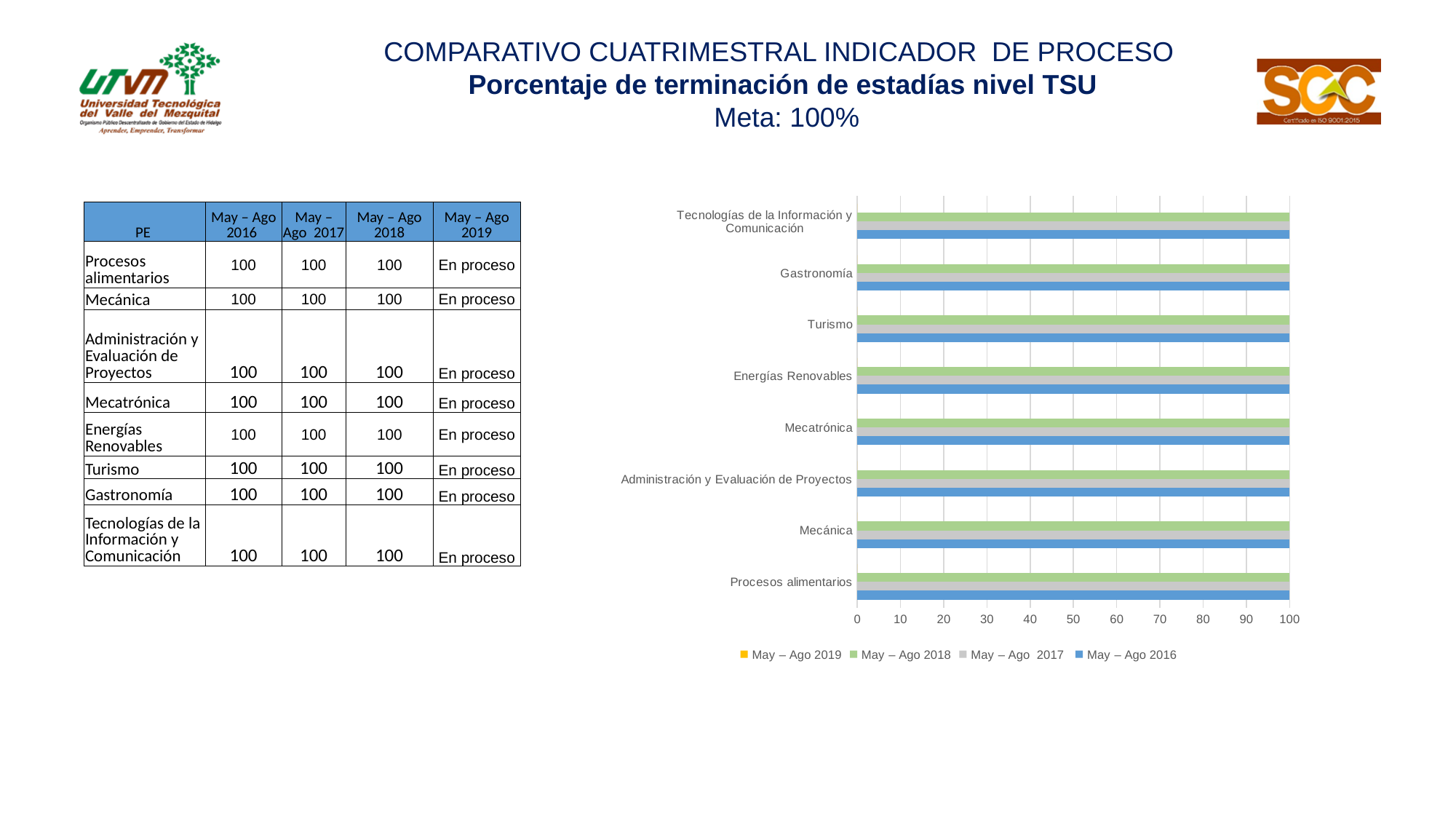
Is the value for Energías Renovables in May – Ago 2018 greater or less than 50? greater What is the highest value shown on the horizontal axis of the chart? 100 What is the difference between the May – Ago 2016 and May – Ago 2018 values for Procesos alimentarios? 0 Which category is listed at the bottom of the chart? Procesos alimentarios What is the value for Gastronomía in the May – Ago 2018 series? 100 What is the value for Mecánica in the May – Ago 2016 series? 100 How many series does the chart legend list? 4 What is the value for Turismo in the May – Ago 2017 series? 100 How many programs (categories) are plotted on the chart? 8 Which series in the legend is shown in blue? May – Ago 2016 What kind of chart is shown on the slide? bar chart